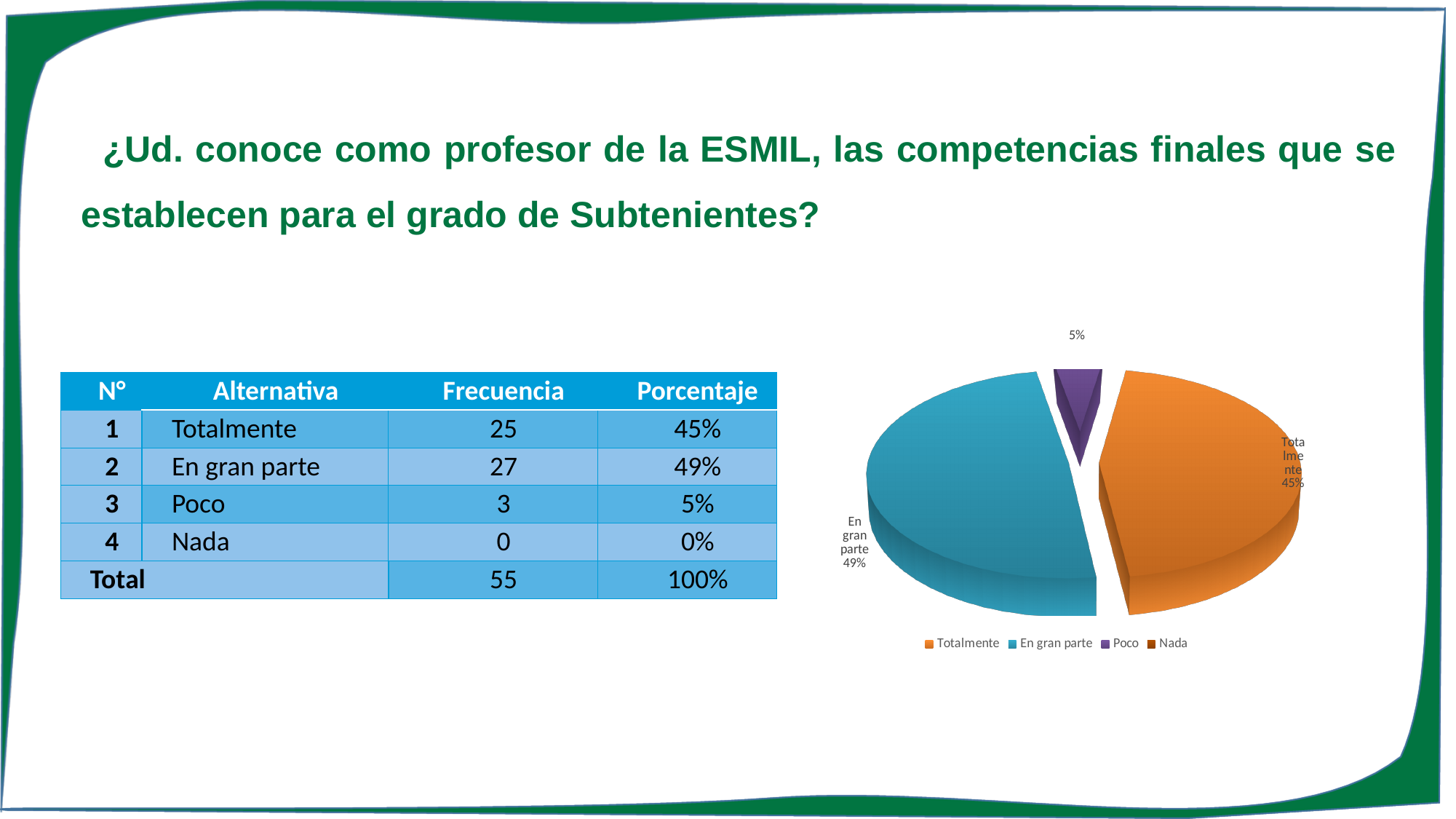
What is the combined share of Totalmente and En gran parte in the pie chart? 94% Which is larger in the pie chart, Totalmente or Poco? Totalmente Which of the slices with a visible percentage label is the smallest in the pie chart? Poco How many entries does the pie chart's legend list? 4 In the pie chart, what percentage is shown for Totalmente? 45% What kind of chart is shown on the slide? pie chart In the pie chart, what percentage is shown for the purple slice (Poco)? 5% What is the difference in percentage points between En gran parte and Totalmente in the pie chart? 4 What colour is the En gran parte slice in the pie chart? teal (blue) Which category has the largest slice in the pie chart? En gran parte What colour is the Totalmente slice in the pie chart? orange In the pie chart, what percentage is shown for En gran parte? 49%